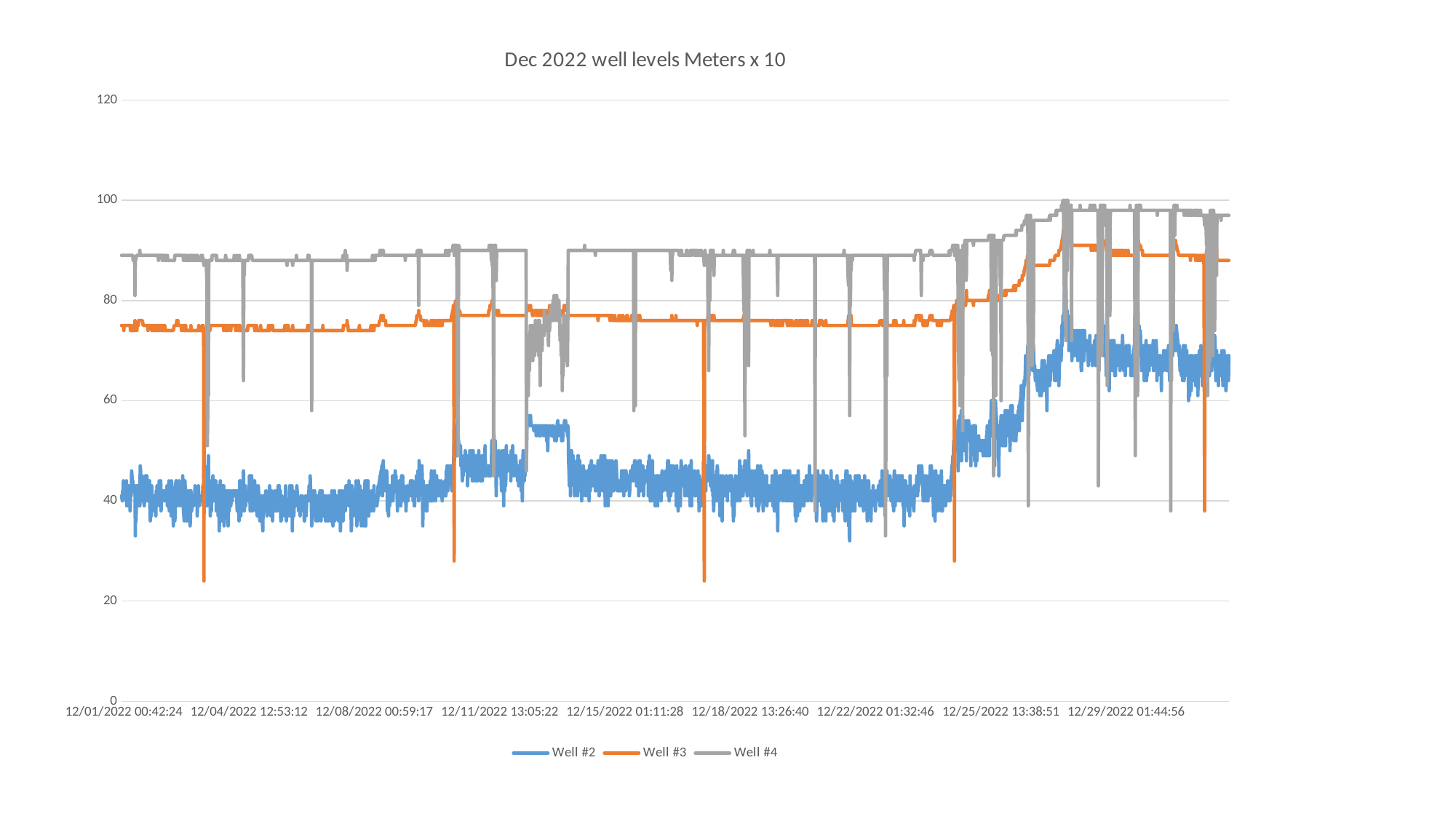
Which series has the highest values across the chart? Well #4 Which series is plotted in orange? Well #3 How many series does the legend list? 3 Around 12/15/2022 01:11:28, which series is larger, Well #3 or Well #2? Well #3 Do the values for Well #4 rise or fall overall from the start of December to the end of December? rise Which series has the lowest values across the chart? Well #2 What is the highest value shown on the vertical axis? 120 What kind of chart is shown on the slide? line chart Is the value for Well #4 at 12/01/2022 00:42:24 greater or less than 80? greater Do the values for Well #2 rise or fall overall from the start of December to the end of December? rise Is the value for Well #2 at 12/01/2022 00:42:24 greater or less than 60? less What is the title of the chart? Dec 2022 well levels Meters x 10